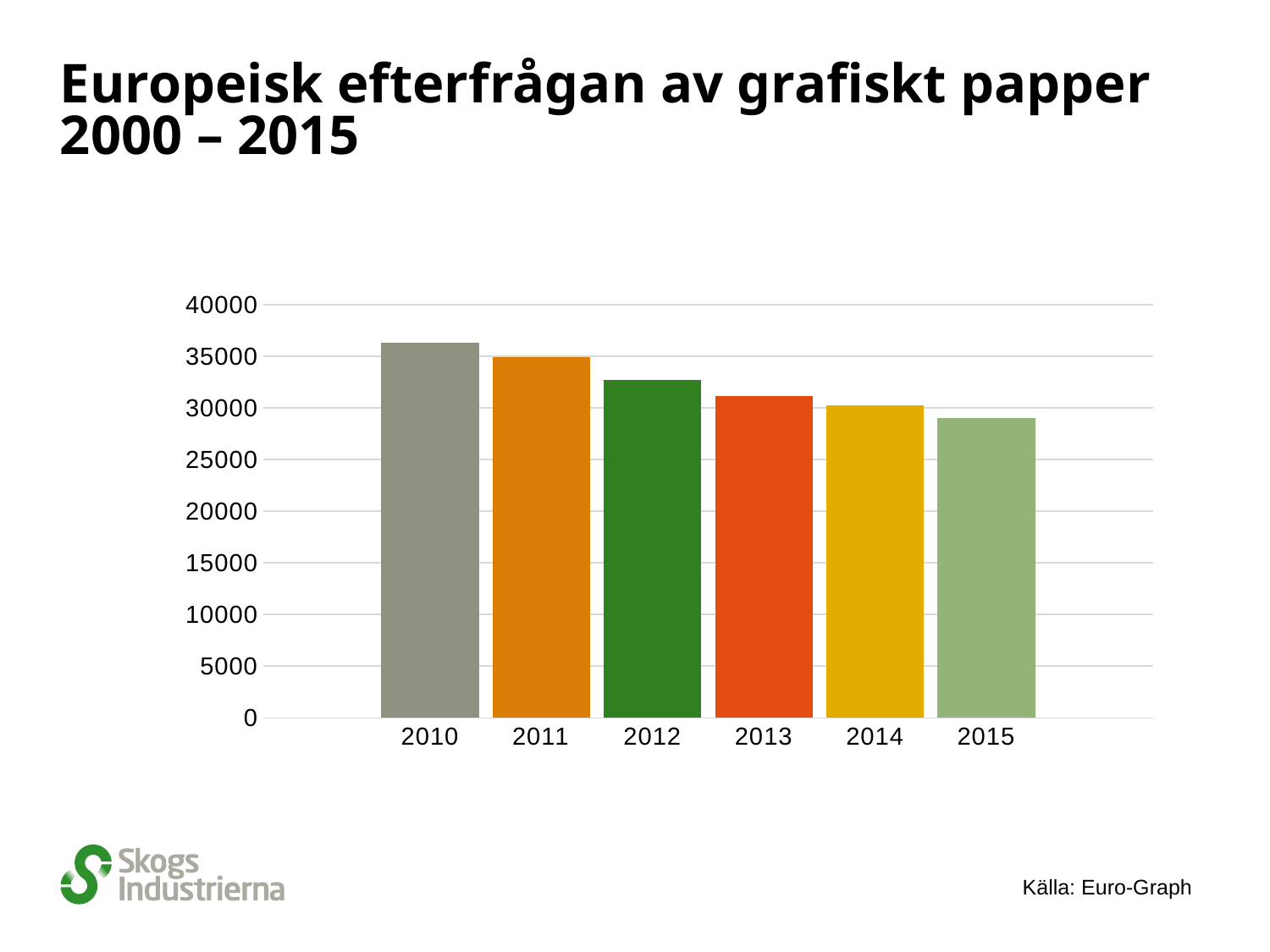
Is the value for 2015 greater or less than 30000? less What is the title of the slide containing the chart? Europeisk efterfrågan av grafiskt papper 2000 – 2015 What kind of chart is shown on the slide? bar chart Is the value for 2013 greater or less than 30000? greater Which year has the highest bar in the chart? 2010 Which is larger, the value for 2010 or the value for 2015? 2010 How many years are shown on the x axis of the chart? 6 Is the value for 2012 greater or less than 35000? less Which is larger, the value for 2012 or the value for 2013? 2012 Which year has the lowest bar in the chart? 2015 Do the values rise or fall from 2010 to 2015? fall